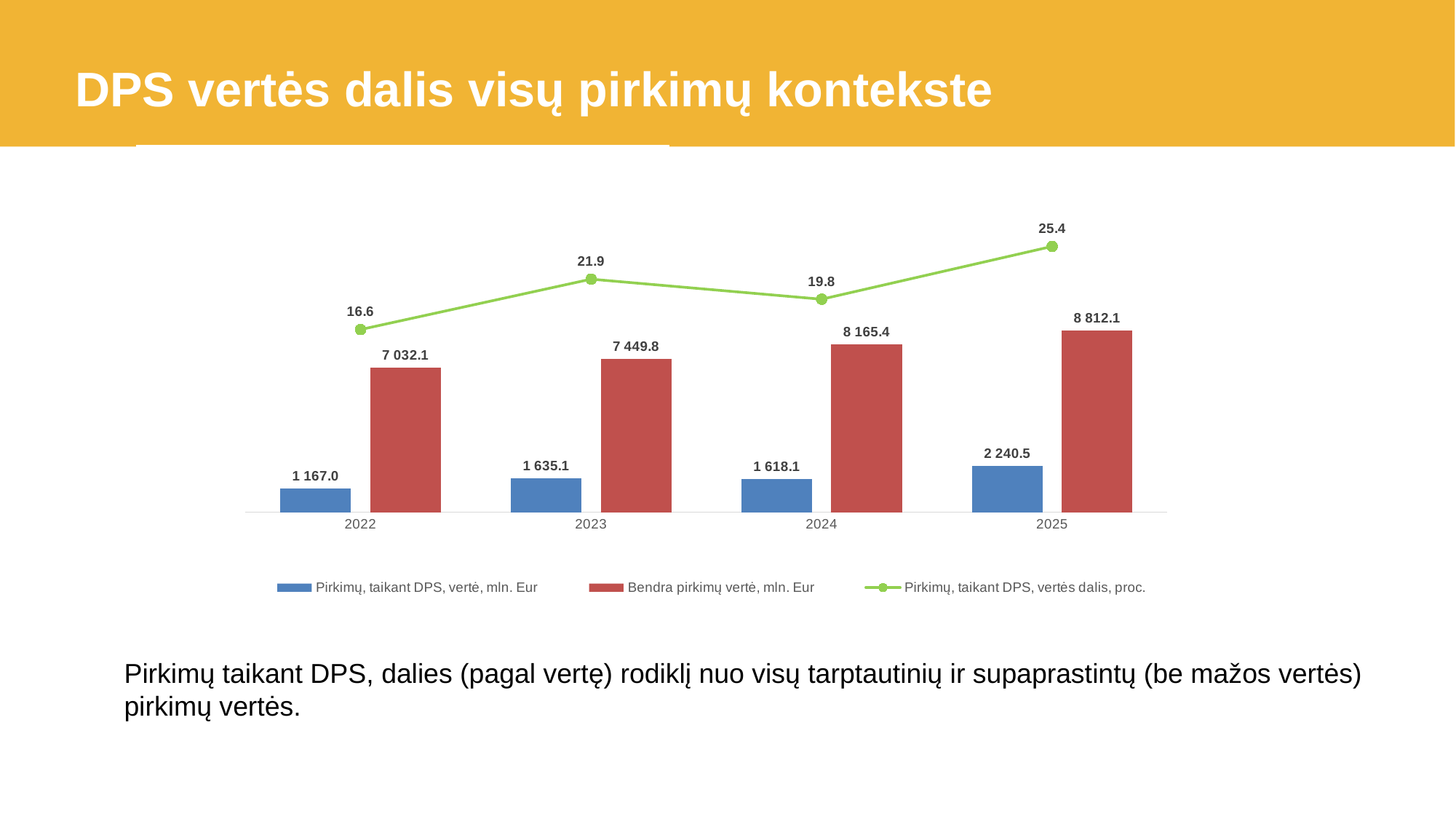
What is the value of 'Bendra pirkimų vertė, mln. Eur' for 2024? 8 165.4 Which year has the larger 'Pirkimų, taikant DPS, vertė, mln. Eur': 2023 or 2025? 2025 By how many percentage points did 'Pirkimų, taikant DPS, vertės dalis, proc.' change from 2022 to 2025? 8.8 Does 'Bendra pirkimų vertė, mln. Eur' rise or fall from 2022 to 2025? Rises In which year is 'Bendra pirkimų vertė, mln. Eur' the lowest? 2022 What is the difference between 'Bendra pirkimų vertė, mln. Eur' in 2025 and in 2022? 1 780.0 In which year is 'Pirkimų, taikant DPS, vertės dalis, proc.' the highest? 2025 What is the value of 'Pirkimų, taikant DPS, vertės dalis, proc.' for 2023? 21.9 What kind of chart is shown on the slide? A bar chart combined with a line chart How many series does the legend list? 3 What is the value of 'Pirkimų, taikant DPS, vertė, mln. Eur' for 2022? 1 167.0 How many years are shown on the x axis of the chart? 4